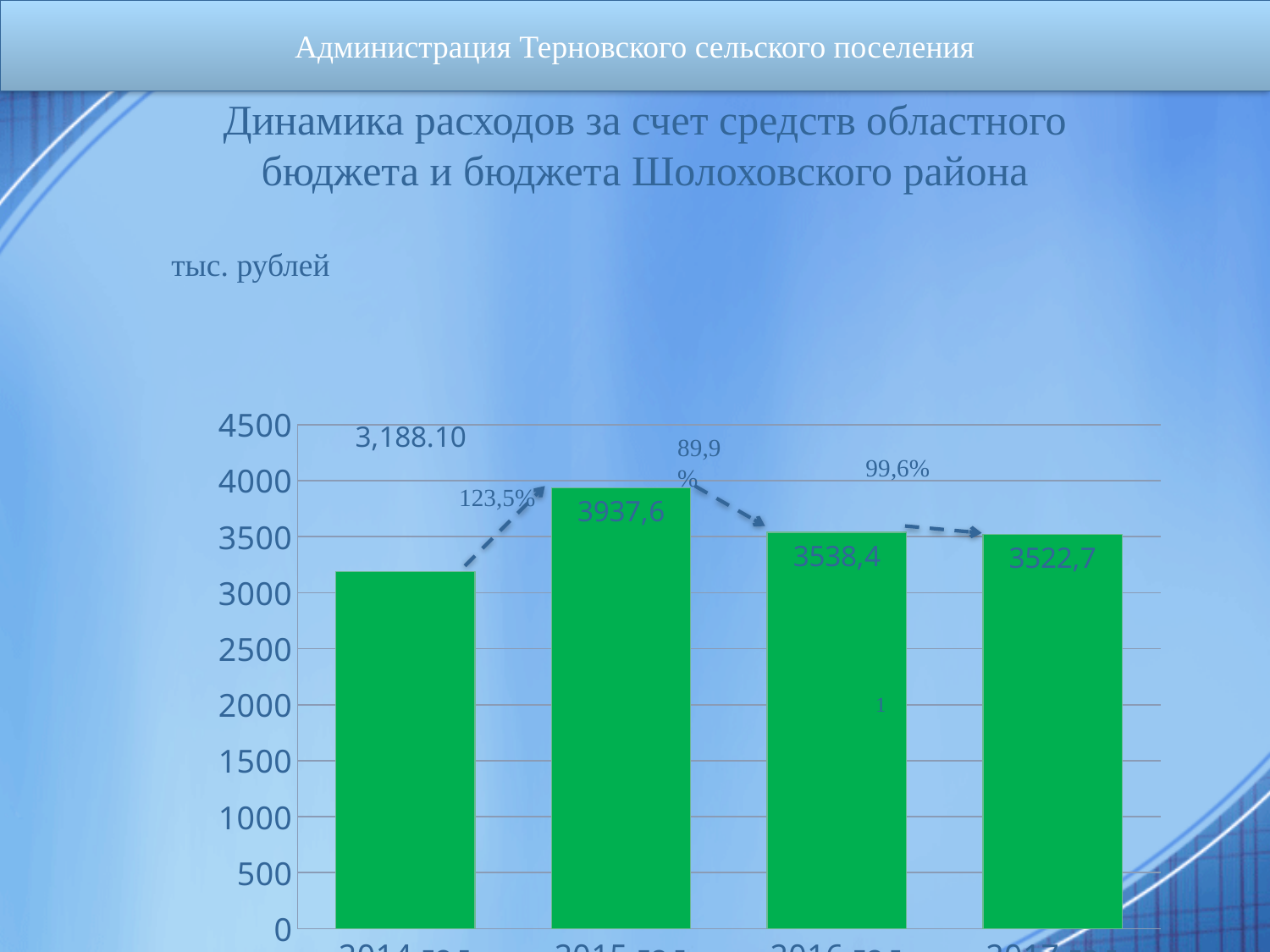
What is the value for 2016 год? 3538,4 What is the value for 2015 год? 3937,6 What is the difference between the values for 2015 год and 2016 год? 399,2 Which year has the highest value? 2015 год What percentage is shown on the arrow between 2014 год and 2015 год? 123,5% Is the value for 2014 год greater or less than 3000? greater What kind of chart is shown on the slide? bar chart How many bars are shown in the chart? 4 Which is larger, the value for 2016 год or 2017 год? 2016 год Which year has the lowest value? 2014 год What is the value for 2014 год? 3,188.10 What is the value for 2017 год? 3522,7